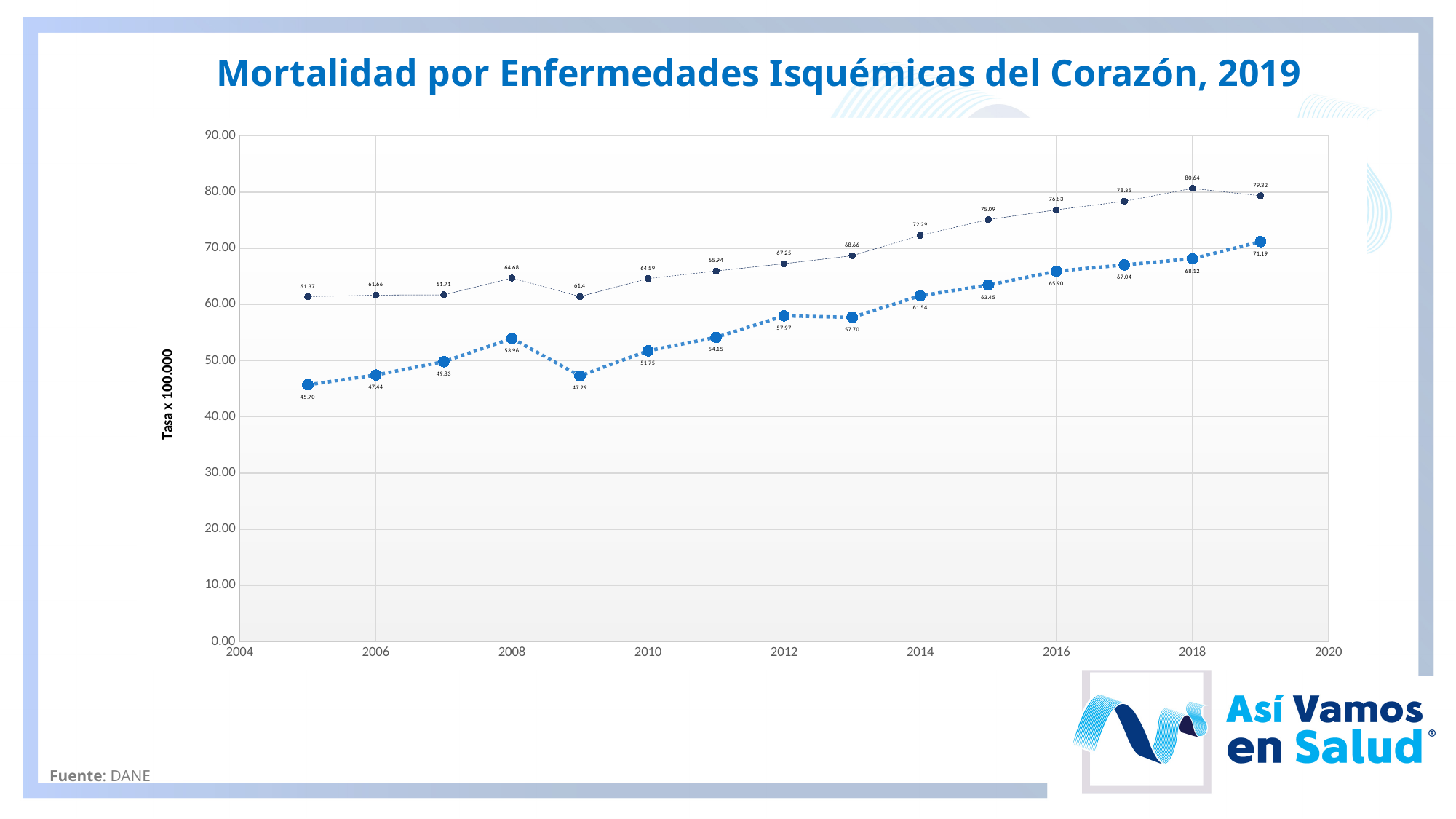
What is the title of the chart? Mortalidad por Enfermedades Isquémicas del Corazón, 2019 What is the difference between the upper thin line and the lower thick dotted line in 2019? 8.13 In which year does the lower thick dotted line have its lowest value? 2005 Overall, does the lower thick dotted line rise or fall from 2005 to 2019? rise How many years (data points) are plotted for each line? 15 In which year does the upper thin line reach its highest value? 2018 What type of chart is shown on the slide? line chart What is the label of the vertical axis? Tasa x 100.000 Which is larger for the lower thick dotted line: the value in 2008 or the value in 2009? 2008 What is the value of the lower thick dotted line in 2005? 45.70 What is the value of the upper thin line in 2018? 80.64 What is the value of the lower thick dotted line in 2019? 71.19